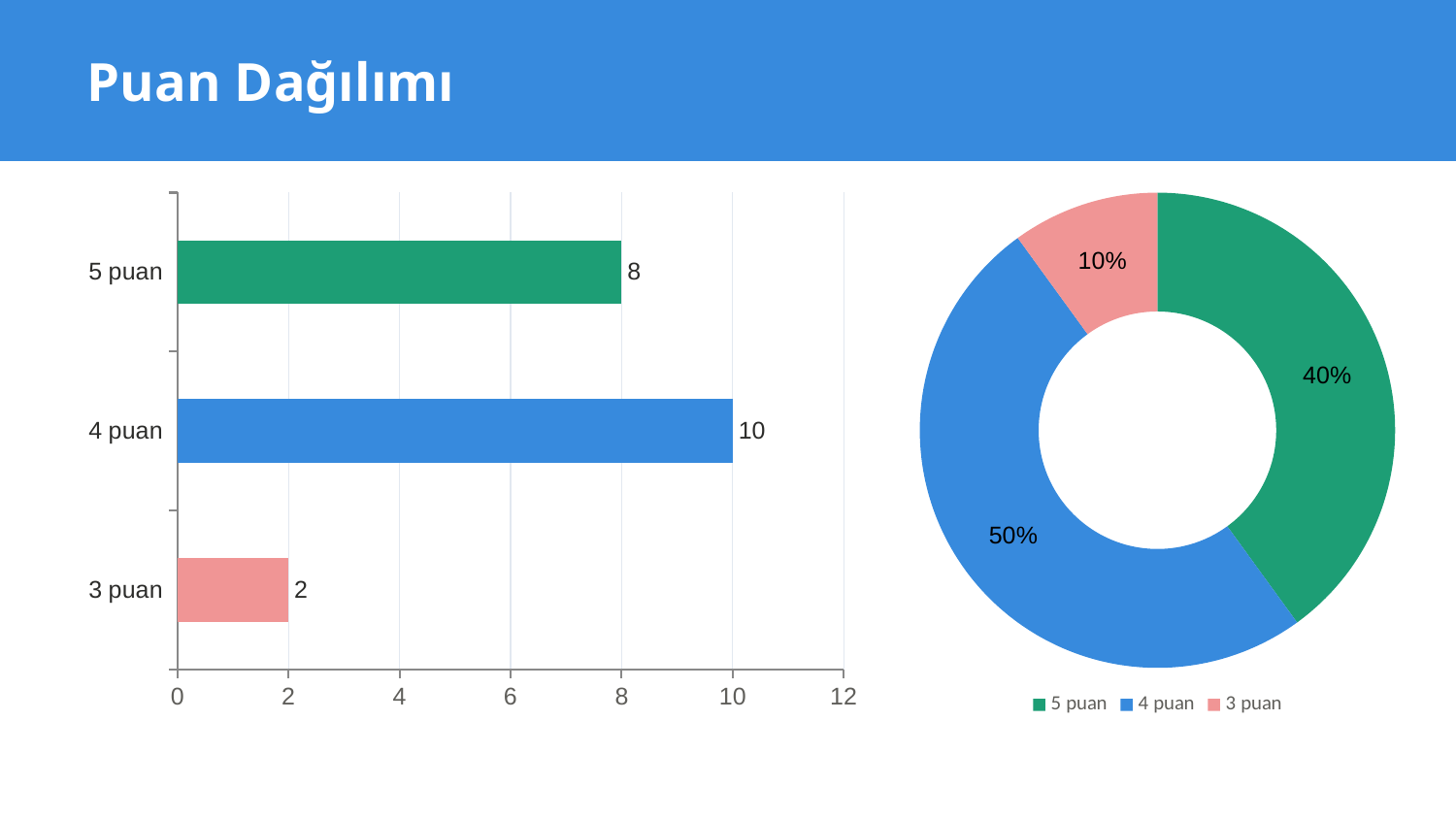
In the bar chart on the left, how many categories are shown? 3 In the doughnut chart on the right, what share does 5 puan have? 40% What kind of chart is on the left side of the slide? bar chart In the doughnut chart on the right, which slice is the largest? 4 puan In the bar chart on the left, what is the value for 3 puan? 2 In the bar chart on the left, which is larger, the value for 5 puan or the value for 3 puan? 5 puan In the doughnut chart on the right, what share does 3 puan have? 10% In the bar chart on the left, what is the value for 4 puan? 10 How many entries does the legend of the doughnut chart on the right list? 3 In the bar chart on the left, which category has the lowest value? 3 puan In the bar chart on the left, what is the difference between the values for 4 puan and 5 puan? 2 In the bar chart on the left, which category has the highest value? 4 puan